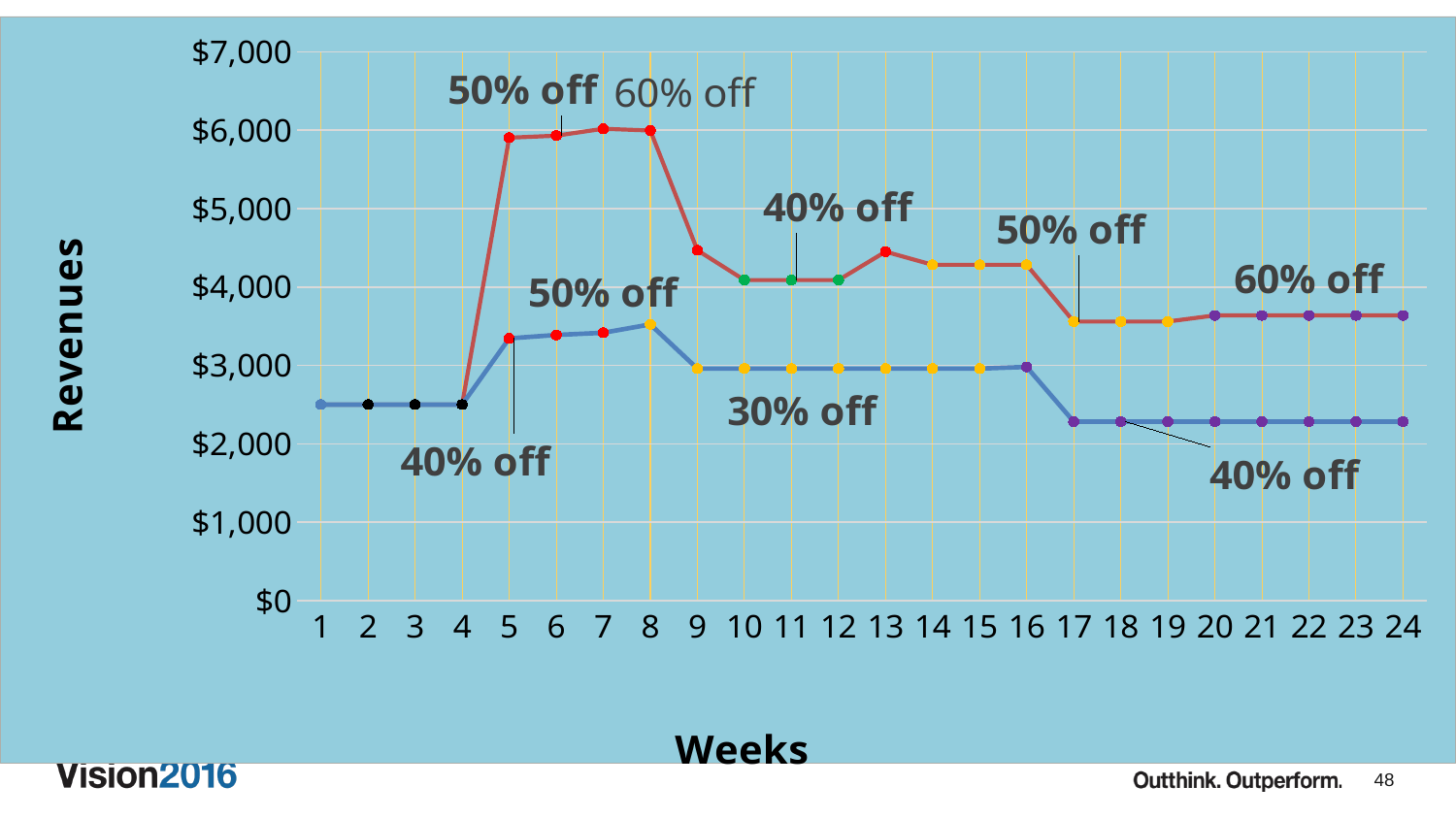
How many weeks are shown on the x axis? 24 Does the blue line rise or fall from week 4 to week 5? rise What kind of chart is shown on the slide? line chart Is the value of the red line at week 20 greater or less than $4,000? less How many lines are plotted on the chart? 2 Is the value of the red line at week 5 greater or less than $5,000? greater Is the value of the red line at week 13 greater or less than $4,000? greater What is the title of the y axis? Revenues At week 5, which line has the higher value, the red line or the blue line? red line Does the red line rise or fall from week 8 to week 9? fall